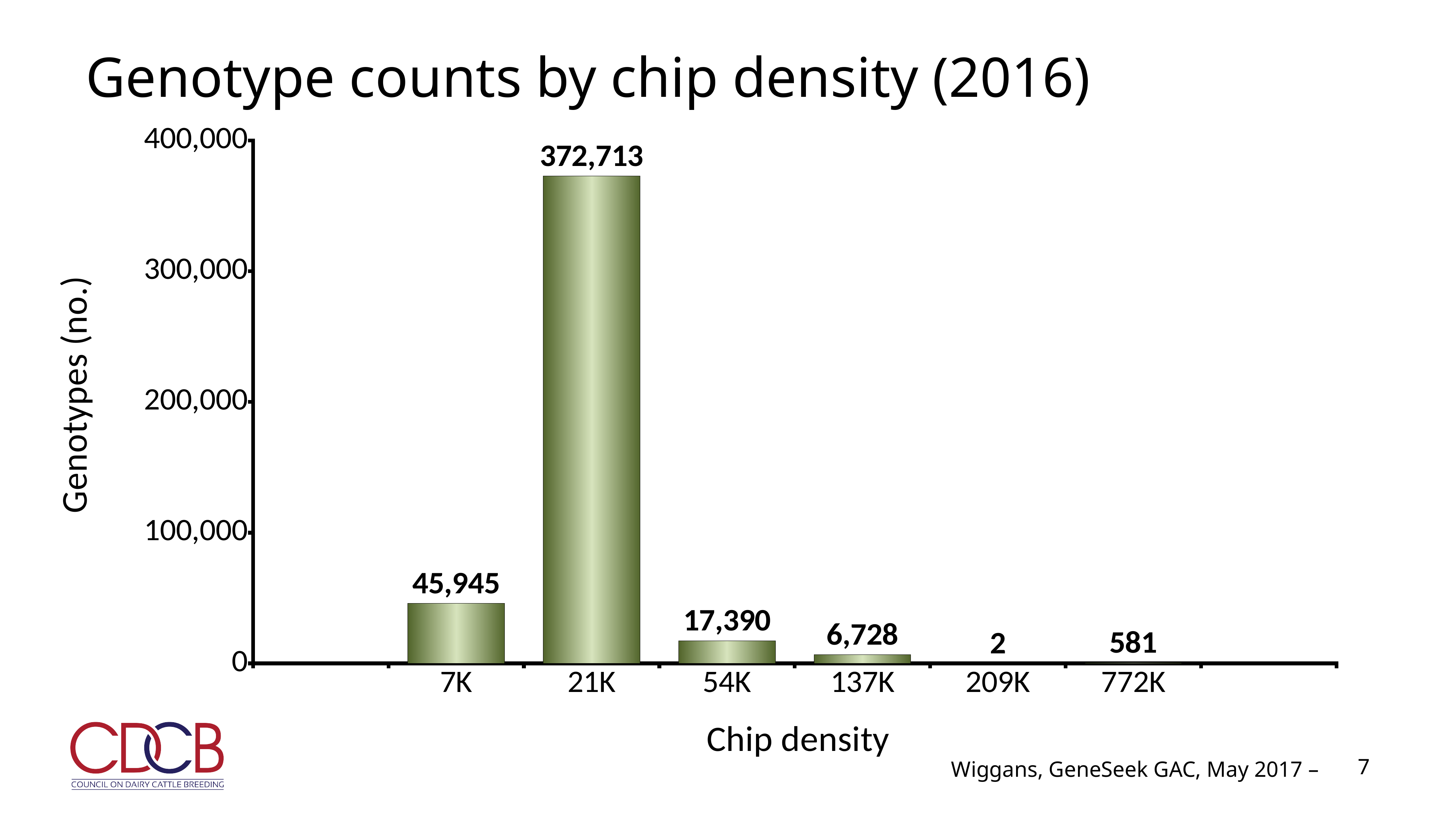
Which chip density has the highest genotype count? 21K How many chip density categories are shown on the chart? 6 What is the genotype count for the 772K chip density? 581 What kind of chart is shown on the slide? Bar chart What is the difference between the genotype counts for 21K and 7K? 326,768 Which chip density has the lowest genotype count? 209K What is the title of the chart? Genotype counts by chip density (2016) Which has a larger genotype count, 7K or 54K? 7K What is the genotype count for the 7K chip density? 45,945 What is the difference between the genotype counts for 54K and 137K? 10,662 What is the genotype count for the 21K chip density? 372,713 What is the genotype count for the 137K chip density? 6,728